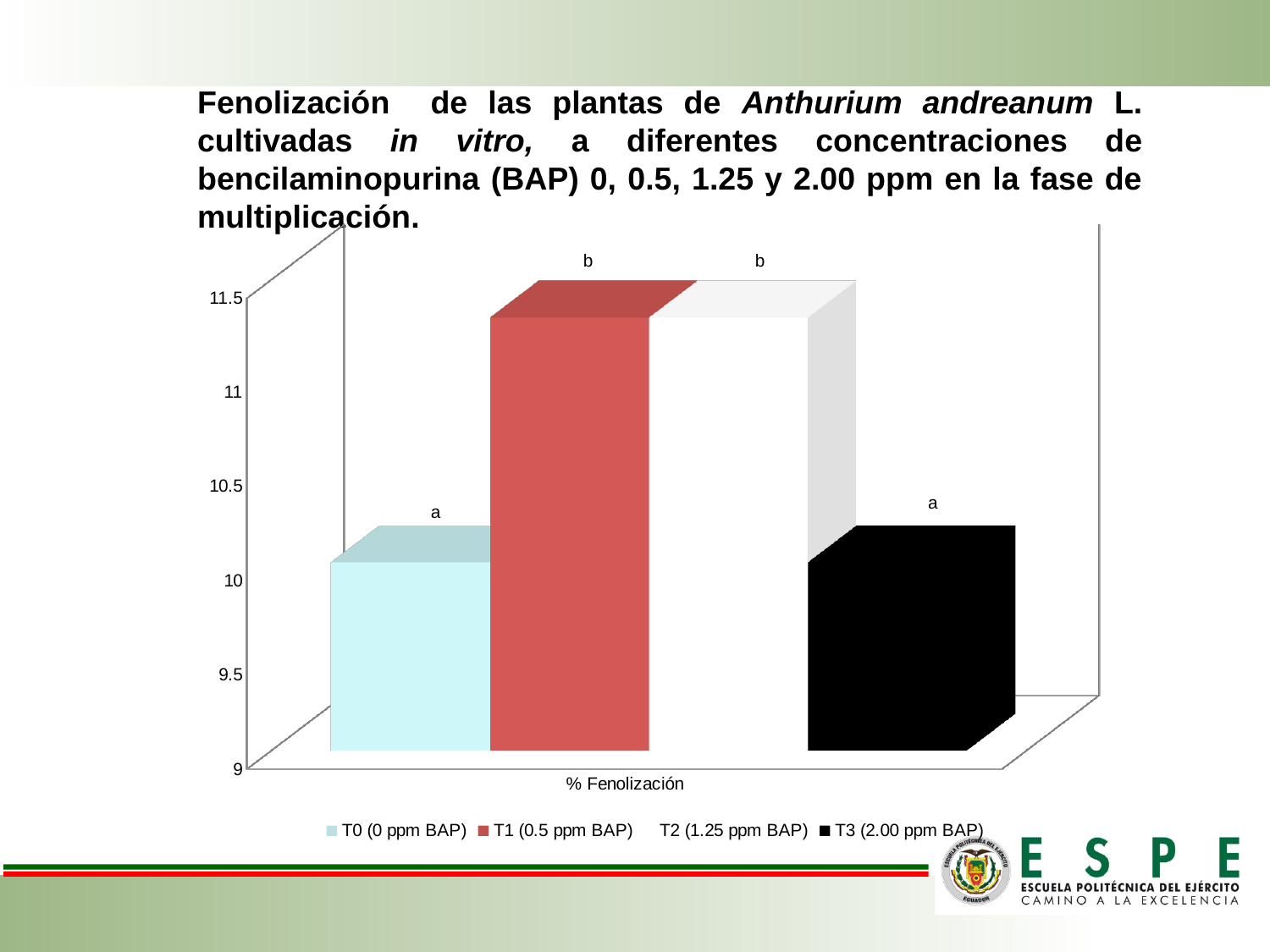
Is the value for T1 (0.5 ppm BAP) greater or less than 11.5? less How many bars are plotted in the chart? 4 What label is shown on the horizontal axis of the chart? % Fenolización Which is larger, the value for T1 (0.5 ppm BAP) or the value for T0 (0 ppm BAP)? T1 (0.5 ppm BAP) Which is larger, the value for T2 (1.25 ppm BAP) or the value for T3 (2.00 ppm BAP)? T2 (1.25 ppm BAP) How many series does the legend list? 4 Is the value for T0 (0 ppm BAP) greater or less than 10.5? less Is the value for T2 (1.25 ppm BAP) greater or less than 11? greater What kind of chart is shown on the slide? bar chart What letter is printed above the T1 (0.5 ppm BAP) bar? b